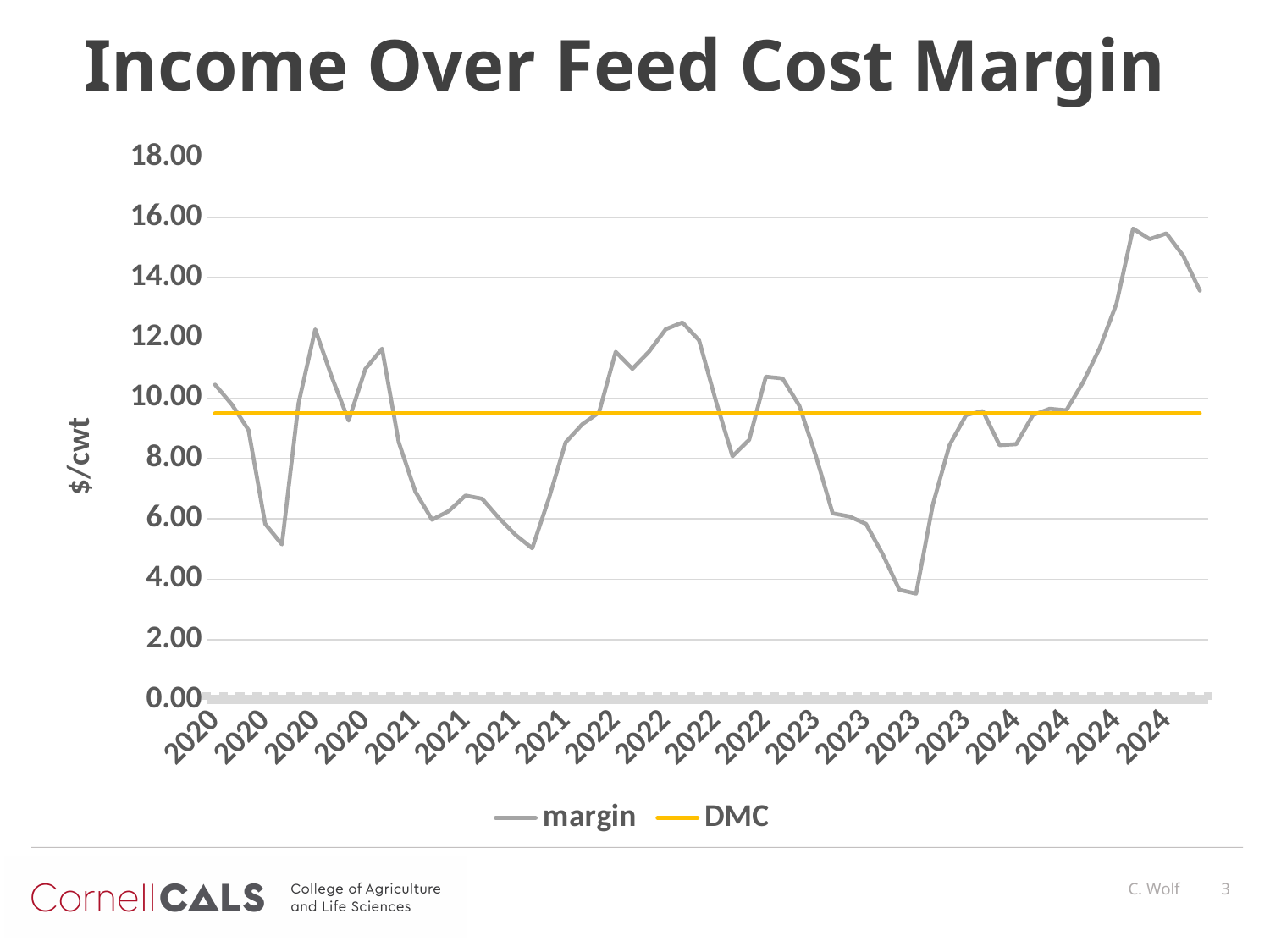
Is the highest value of the margin series, reached in 2024, greater or less than 14.00? greater What type of chart is shown on the slide? line chart How many series does the legend list? 2 Is the value of the DMC line greater or less than 10.00? less Does the margin series rise or fall from the start of 2024 to its peak later in 2024? rise What are the two series named in the legend? margin and DMC How many distinct years appear on the x axis? 5 At the last point on the x axis, which series has the higher value, margin or DMC? margin What is the label on the vertical axis? $/cwt What is the title of the chart? Income Over Feed Cost Margin Is the lowest value of the margin series, reached in 2023, greater or less than 4.00? less